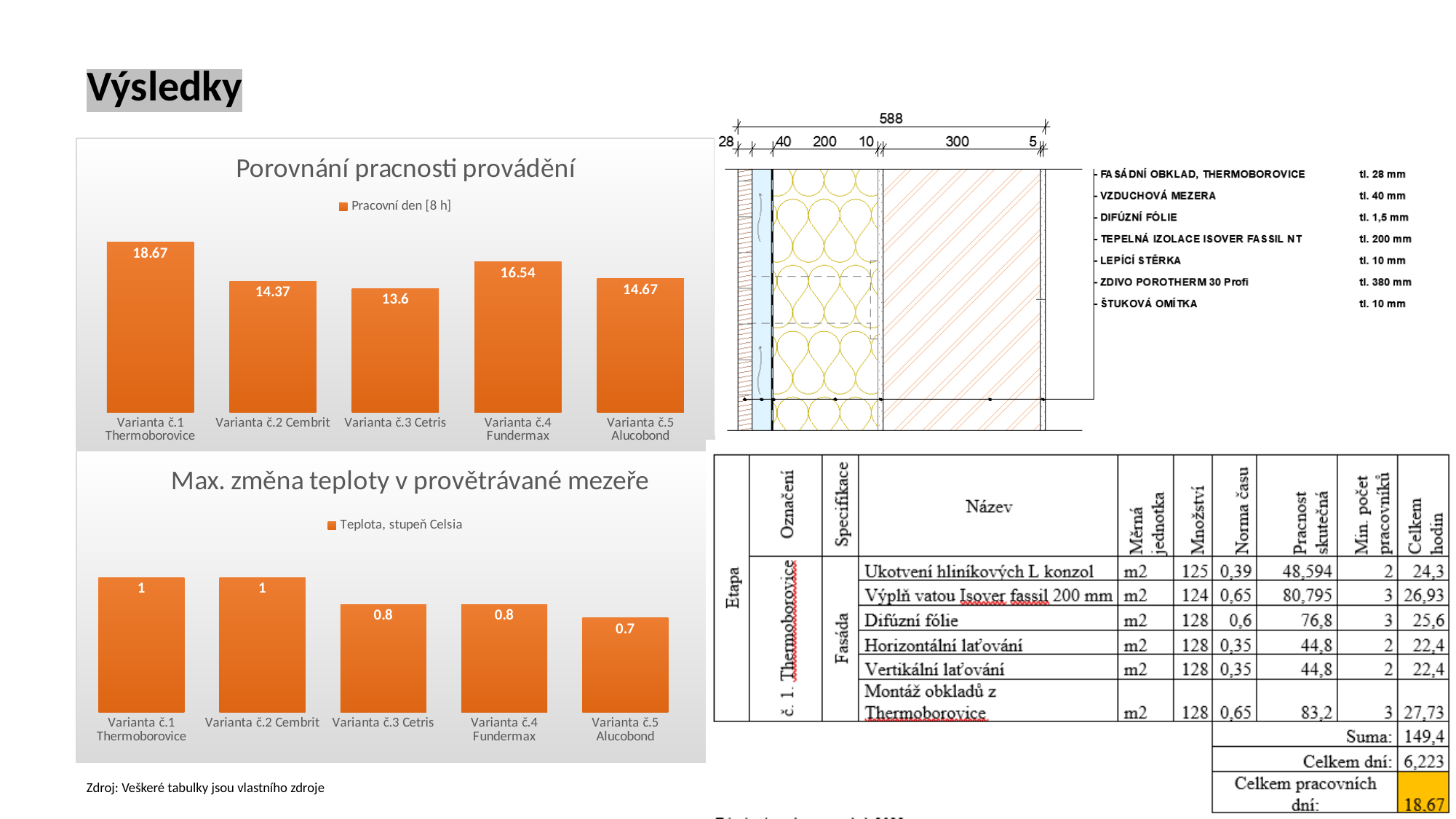
In the chart 'Porovnání pracnosti provádění', which variant has the highest value? Varianta č.1 Thermoborovice What is the legend entry of the chart 'Max. změna teploty v provětrávané mezeře'? Teplota, stupeň Celsia In the chart 'Max. změna teploty v provětrávané mezeře', which variant has the lowest value? Varianta č.5 Alucobond What type of chart is 'Max. změna teploty v provětrávané mezeře'? bar chart In the chart 'Porovnání pracnosti provádění', what is the value for Varianta č.1 Thermoborovice? 18.67 In the chart 'Max. změna teploty v provětrávané mezeře', what is the value for Varianta č.5 Alucobond? 0.7 In the chart 'Porovnání pracnosti provádění', which is larger: Varianta č.4 Fundermax or Varianta č.5 Alucobond? Varianta č.4 Fundermax In the chart 'Porovnání pracnosti provádění', which variant has the lowest value? Varianta č.3 Cetris How many variants are shown in the chart 'Porovnání pracnosti provádění'? 5 In the chart 'Max. změna teploty v provětrávané mezeře', what is the value for Varianta č.3 Cetris? 0.8 How many series does the legend of the chart 'Porovnání pracnosti provádění' list? 1 In the chart 'Porovnání pracnosti provádění', what is the difference between Varianta č.1 Thermoborovice and Varianta č.3 Cetris? 5.07